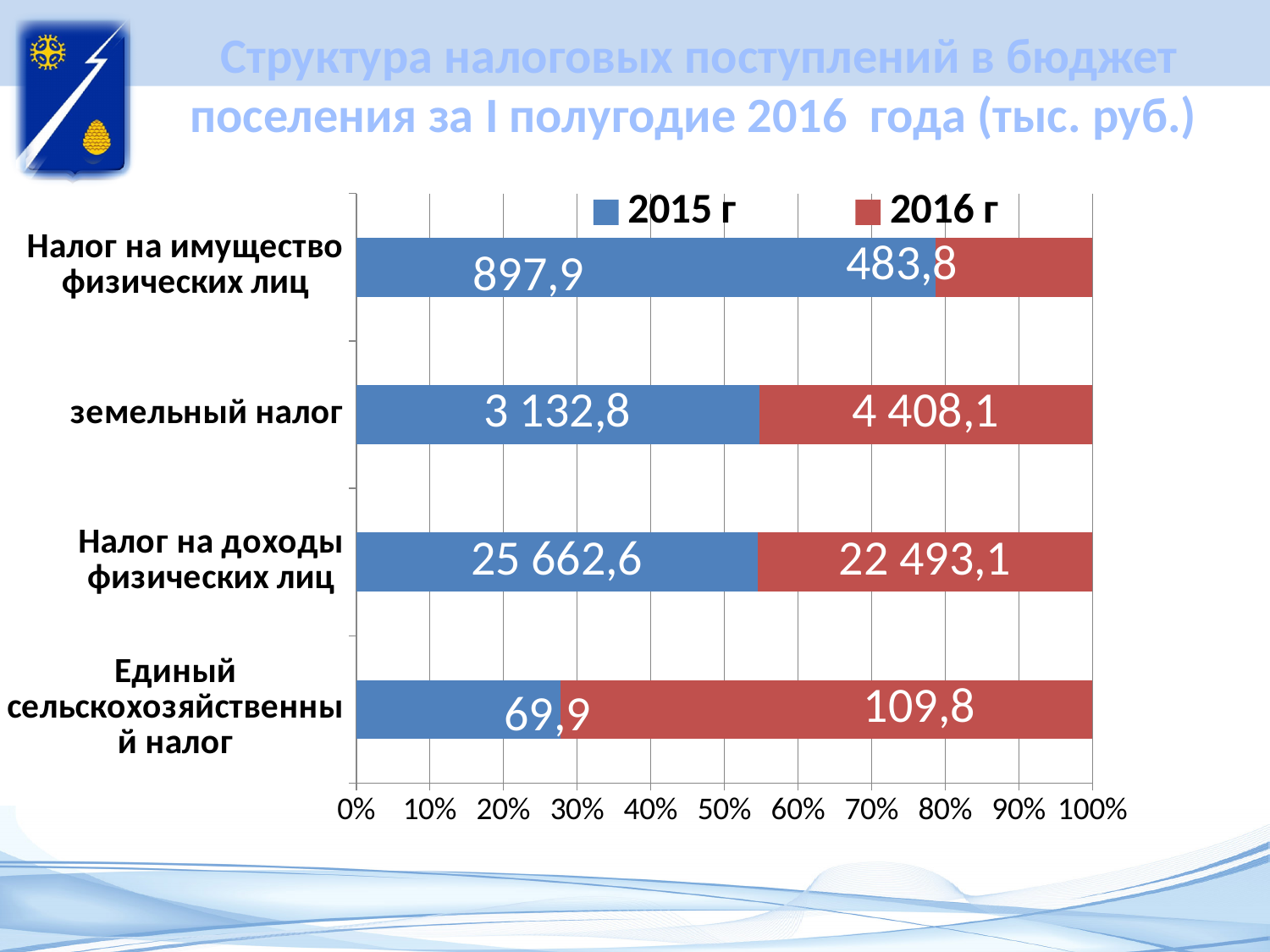
What kind of chart is shown on the slide? Stacked bar chart What is the 2015 г value for Налог на имущество физических лиц? 897,9 How many series does the legend list? 2 What is the 2016 г value for земельный налог? 4 408,1 What is the difference between the 2015 г and 2016 г values for земельный налог? 1 275,3 How many tax categories are shown on the chart? 4 What is the 2015 г value for Единый сельскохозяйственный налог? 69,9 For Единый сельскохозяйственный налог, which year has the larger value, 2015 г or 2016 г? 2016 г Which category has the lowest 2016 г value? Единый сельскохозяйственный налог Which category has the highest 2015 г value? Налог на доходы физических лиц What is the 2016 г value for Налог на доходы физических лиц? 22 493,1 What is the difference between the 2015 г and 2016 г values for Налог на имущество физических лиц? 414,1